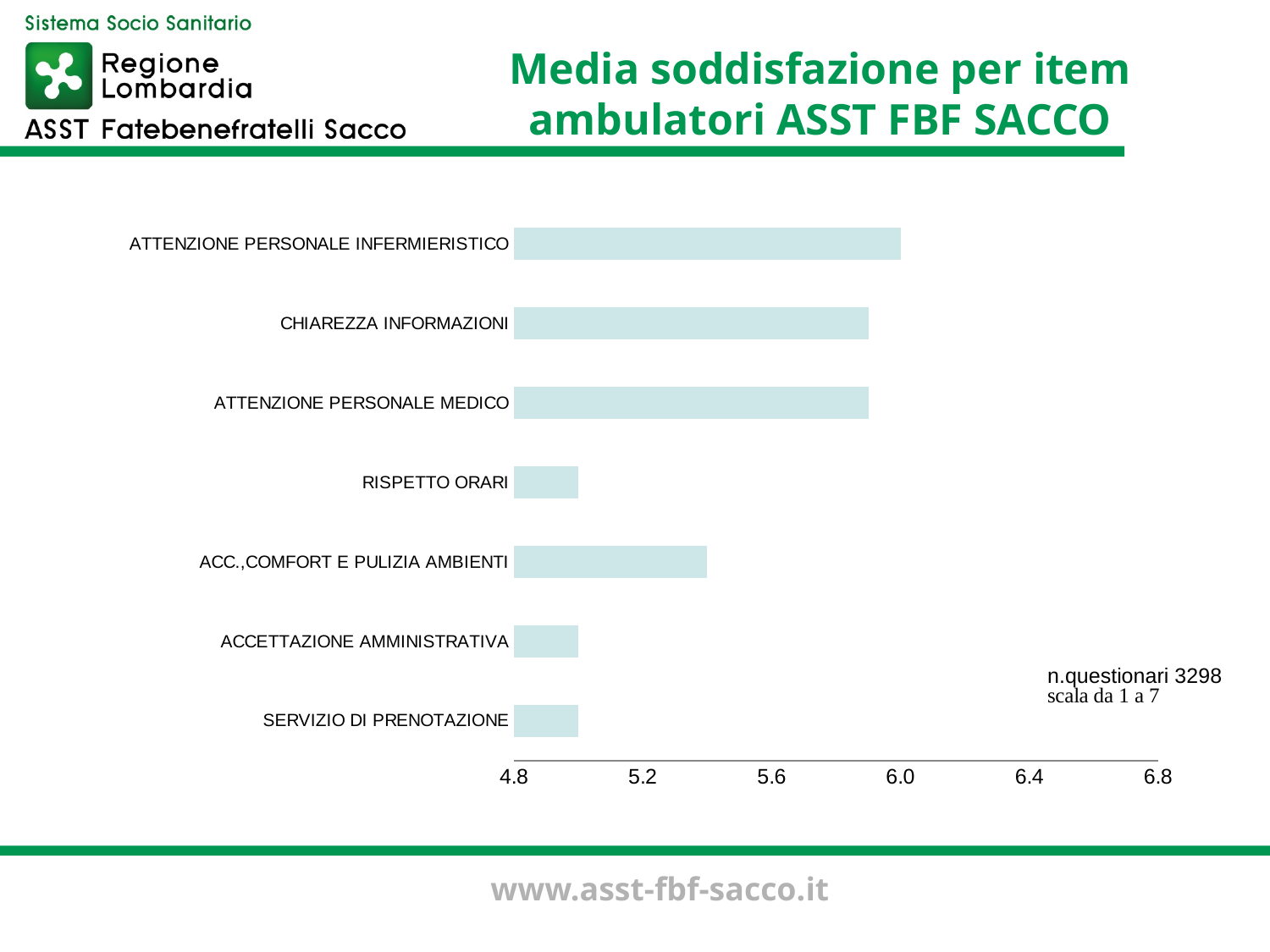
Is the value for ACC.,COMFORT E PULIZIA AMBIENTI greater or less than 5.2? greater What kind of chart is shown on the slide? bar chart How many categories (items) are plotted in the chart? 7 Is the value for ACC.,COMFORT E PULIZIA AMBIENTI greater or less than 5.6? less Is the value for SERVIZIO DI PRENOTAZIONE greater or less than 5.2? less Which is larger, the value for CHIAREZZA INFORMAZIONI or the value for ACC.,COMFORT E PULIZIA AMBIENTI? CHIAREZZA INFORMAZIONI Which is larger, the value for ATTENZIONE PERSONALE INFERMIERISTICO or the value for ACCETTAZIONE AMMINISTRATIVA? ATTENZIONE PERSONALE INFERMIERISTICO According to the note on the chart, how many questionnaires (n.questionari) were collected? 3298 Which item has the highest mean satisfaction in the chart? ATTENZIONE PERSONALE INFERMIERISTICO